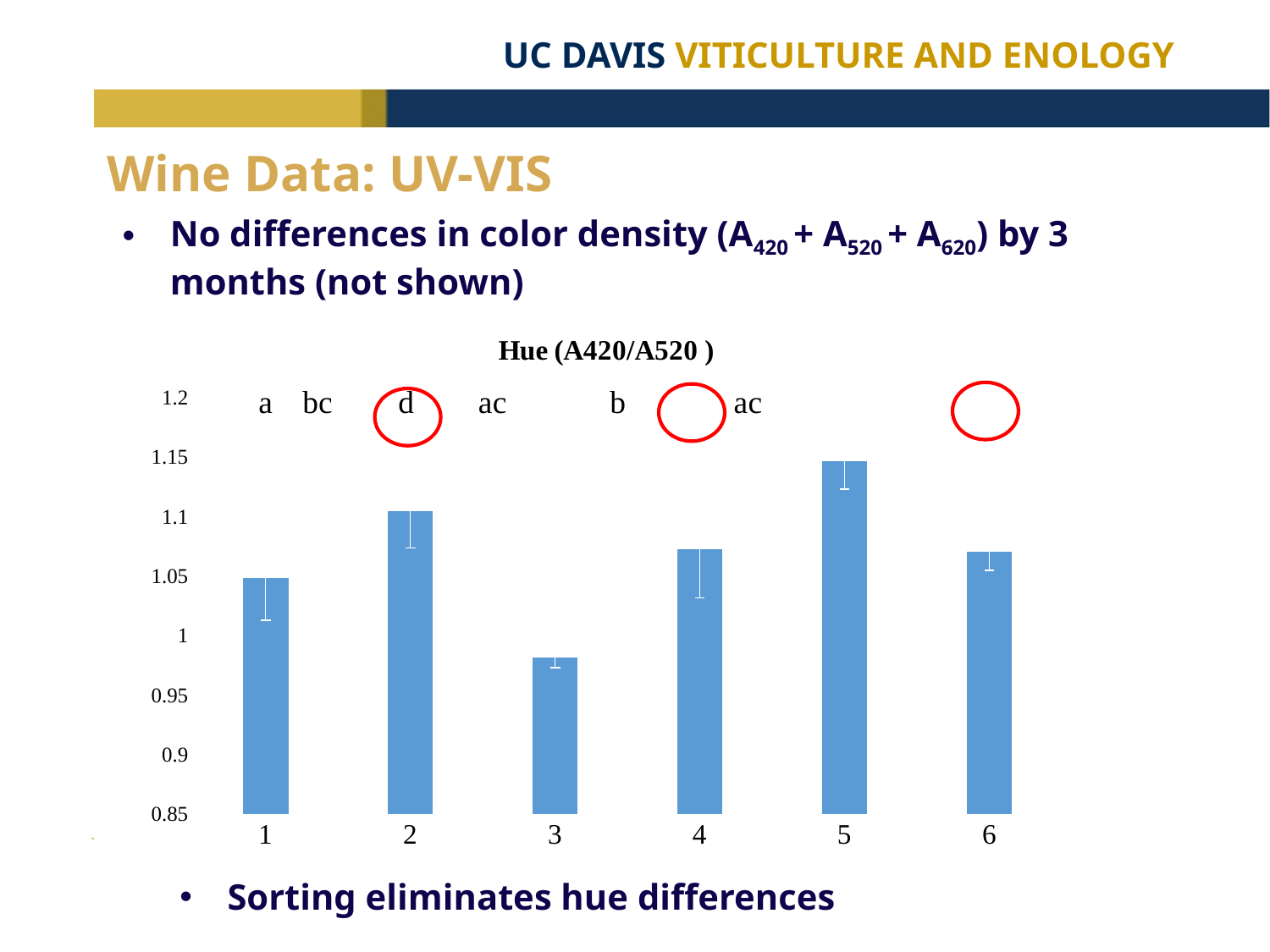
What is the title of the chart? Hue (A420/A520 ) Which has the larger value, category 2 or category 4? 2 Is the value for category 4 greater or less than 1.05? greater Is the value for category 5 greater or less than 1.1? greater How many categories are plotted on the x axis of the chart? 6 Which has the larger value, category 1 or category 3? 1 Is the value for category 6 greater or less than 1.1? less Which category has the lowest bar in the chart? 3 What kind of chart is shown on the slide? bar chart Which category has the highest bar in the chart? 5